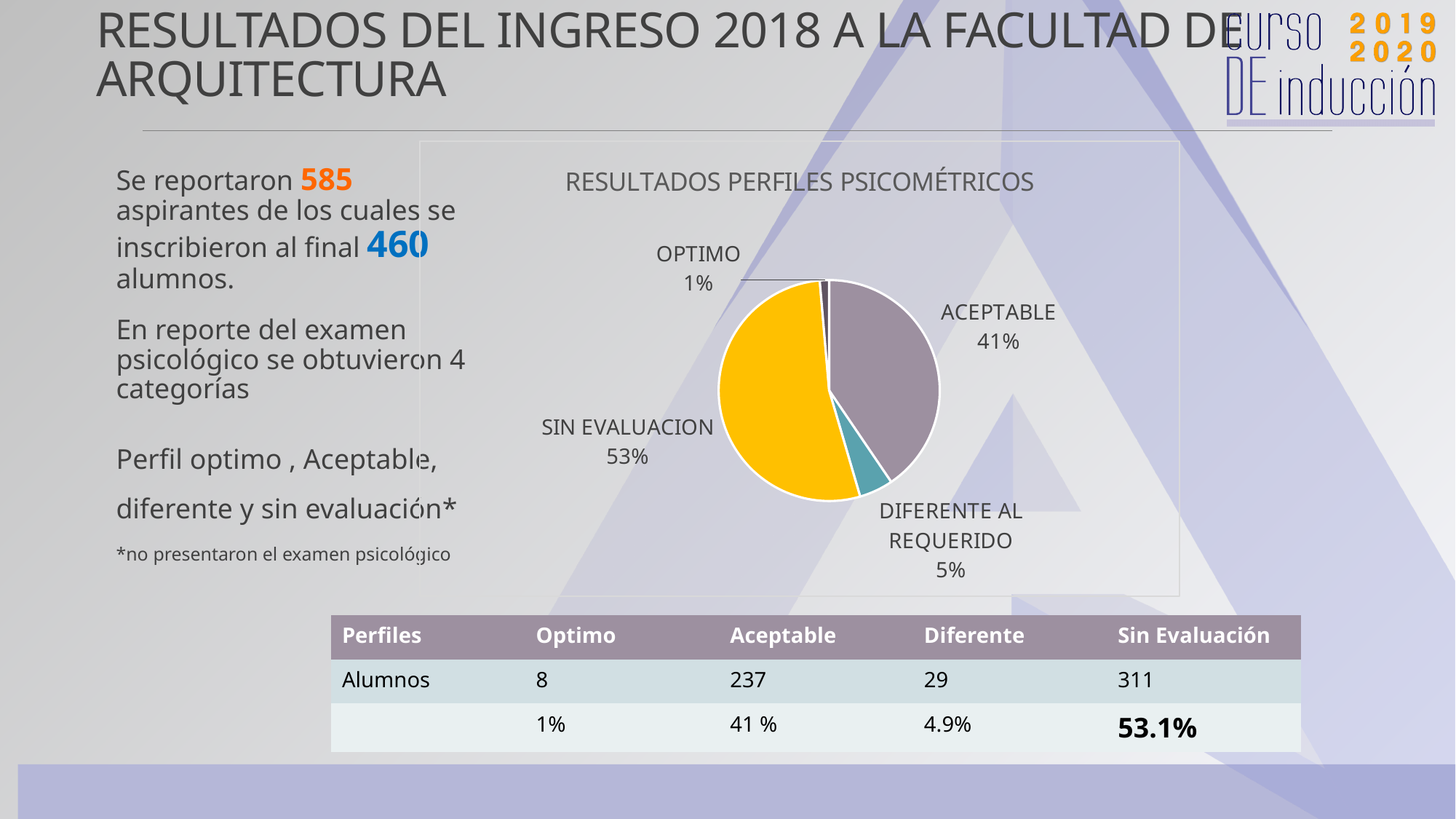
Which category has the smallest slice of the pie? OPTIMO What percentage does the OPTIMO slice show? 1% What is the difference in percentage points between the SIN EVALUACION and ACEPTABLE slices? 12 Which slice is larger, ACEPTABLE or DIFERENTE AL REQUERIDO? ACEPTABLE What percentage does the ACEPTABLE slice show? 41% What is the title of the chart? RESULTADOS PERFILES PSICOMÉTRICOS What percentage does the SIN EVALUACION slice show? 53% What percentage does the DIFERENTE AL REQUERIDO slice show? 5% What colour is the SIN EVALUACION slice? yellow What kind of chart is shown on the slide? pie chart How many slices does the pie chart have? 4 Which category has the largest slice of the pie? SIN EVALUACION